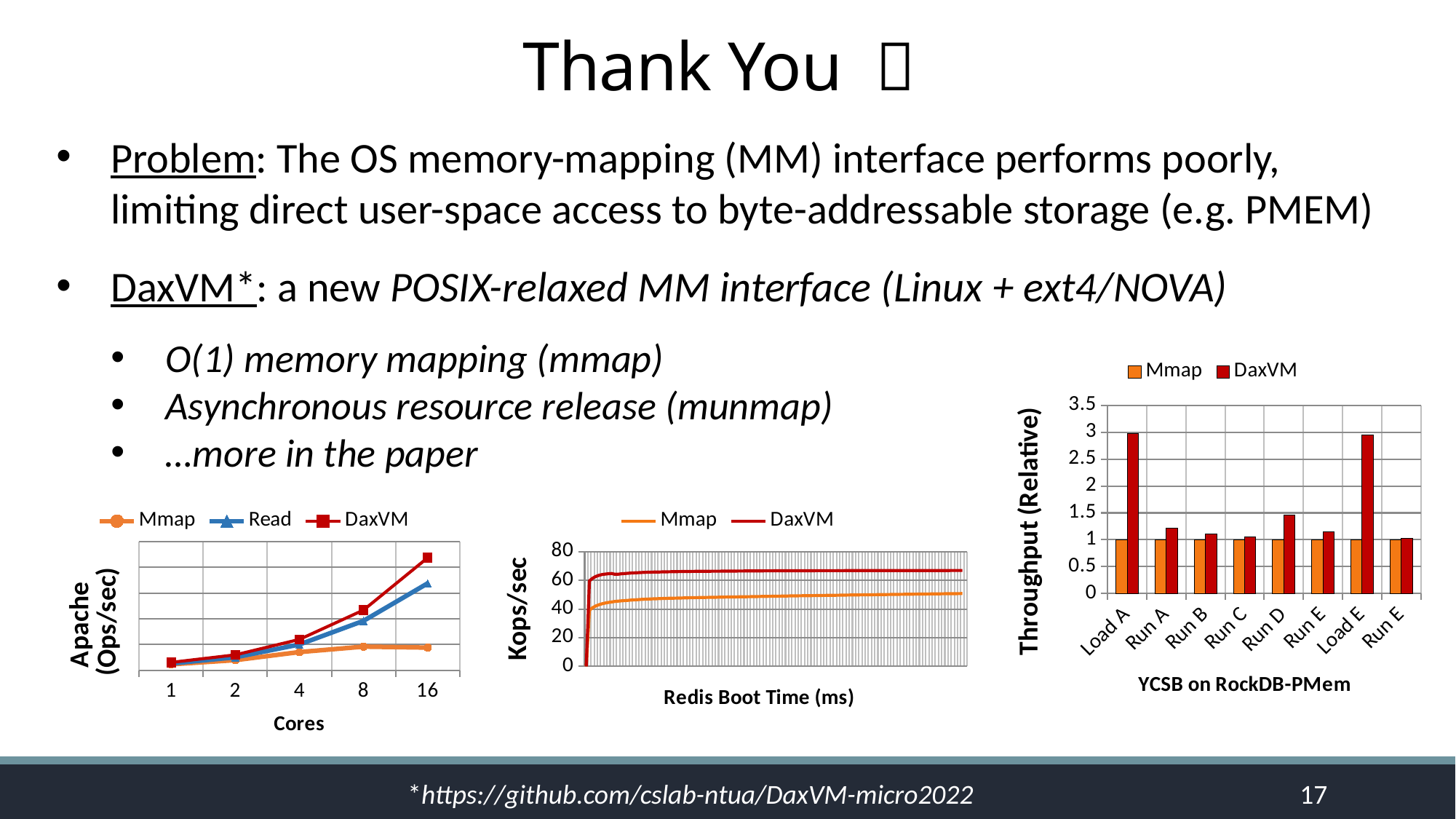
In the YCSB on RockDB-PMem chart, is the DaxVM value for Load A greater or less than 2.5? greater How many categories are shown on the x axis of the YCSB on RockDB-PMem chart? 8 How many core counts are shown on the x axis of the Apache (Ops/sec) chart on the left? 5 What is the y-axis label of the Redis Boot Time chart in the middle? Kops/sec In the Apache (Ops/sec) chart on the left, which series has the highest value at 16 cores? DaxVM What kind of chart is the YCSB on RockDB-PMem chart on the right? bar chart In the Redis Boot Time chart in the middle, is the steady DaxVM value greater or less than 60 Kops/sec? greater How many series does the legend of the YCSB on RockDB-PMem chart list? 2 How many series does the legend of the Apache (Ops/sec) chart on the left list? 3 In the YCSB on RockDB-PMem chart, is the DaxVM value for Run D greater or less than 2? less In the YCSB on RockDB-PMem chart, what is the Mmap value for Load A? 1 In the YCSB on RockDB-PMem chart, which is larger: the DaxVM value for Run D or the DaxVM value for Run B? Run D